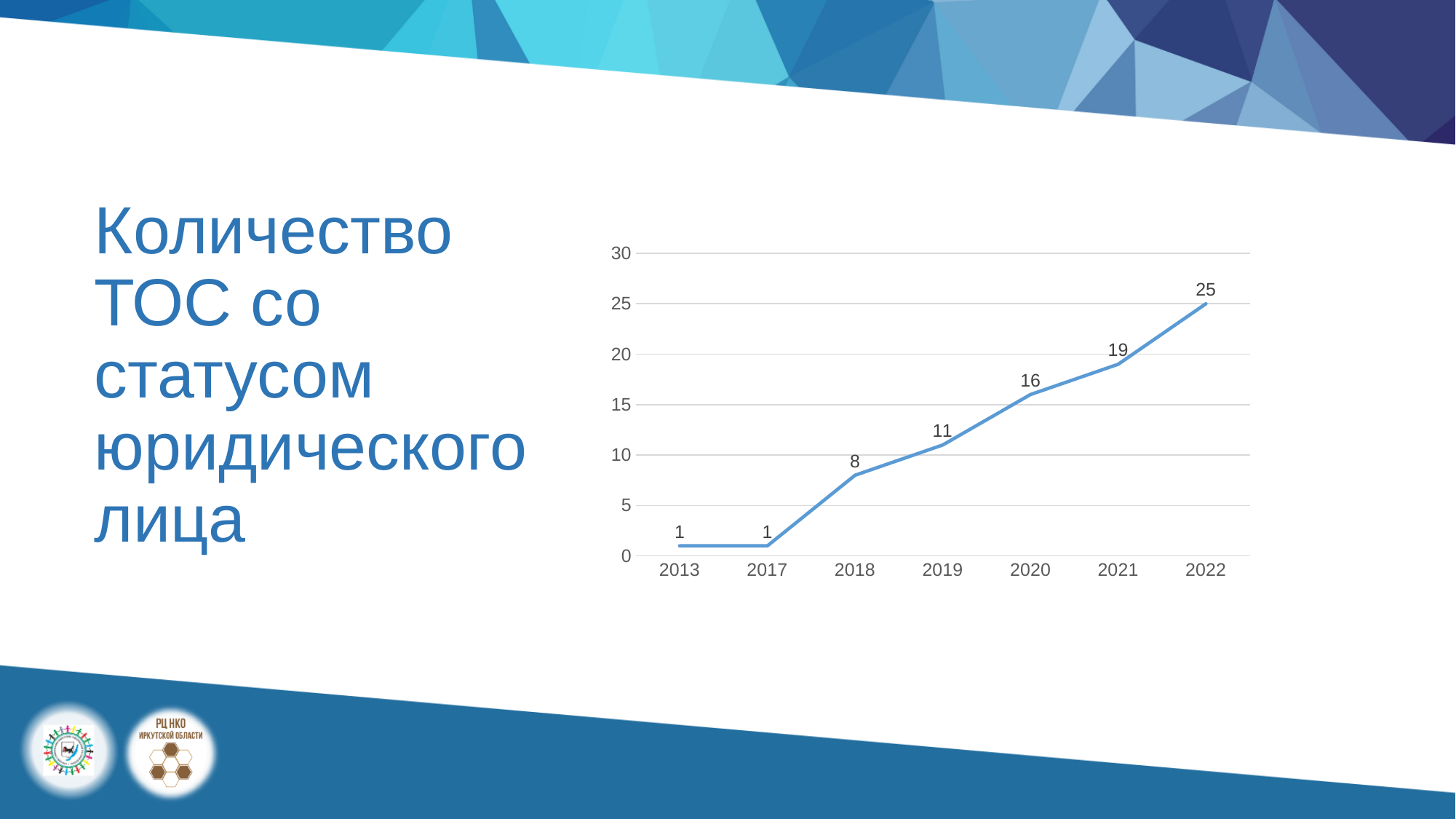
What is the value for 2020? 16 What is the difference between the values for 2022 and 2021? 6 Which is larger, the value for 2019 or the value for 2020? 2020 How many years are plotted on the x axis? 7 What kind of chart is shown on the slide? line chart Which year has the highest value? 2022 What is the difference between the values for 2019 and 2018? 3 Is the value for 2021 greater or less than 15? greater What is the value for 2022? 25 What is the lowest value shown on the chart? 1 Do the values rise or fall from 2017 to 2022? rise What is the value for 2018? 8